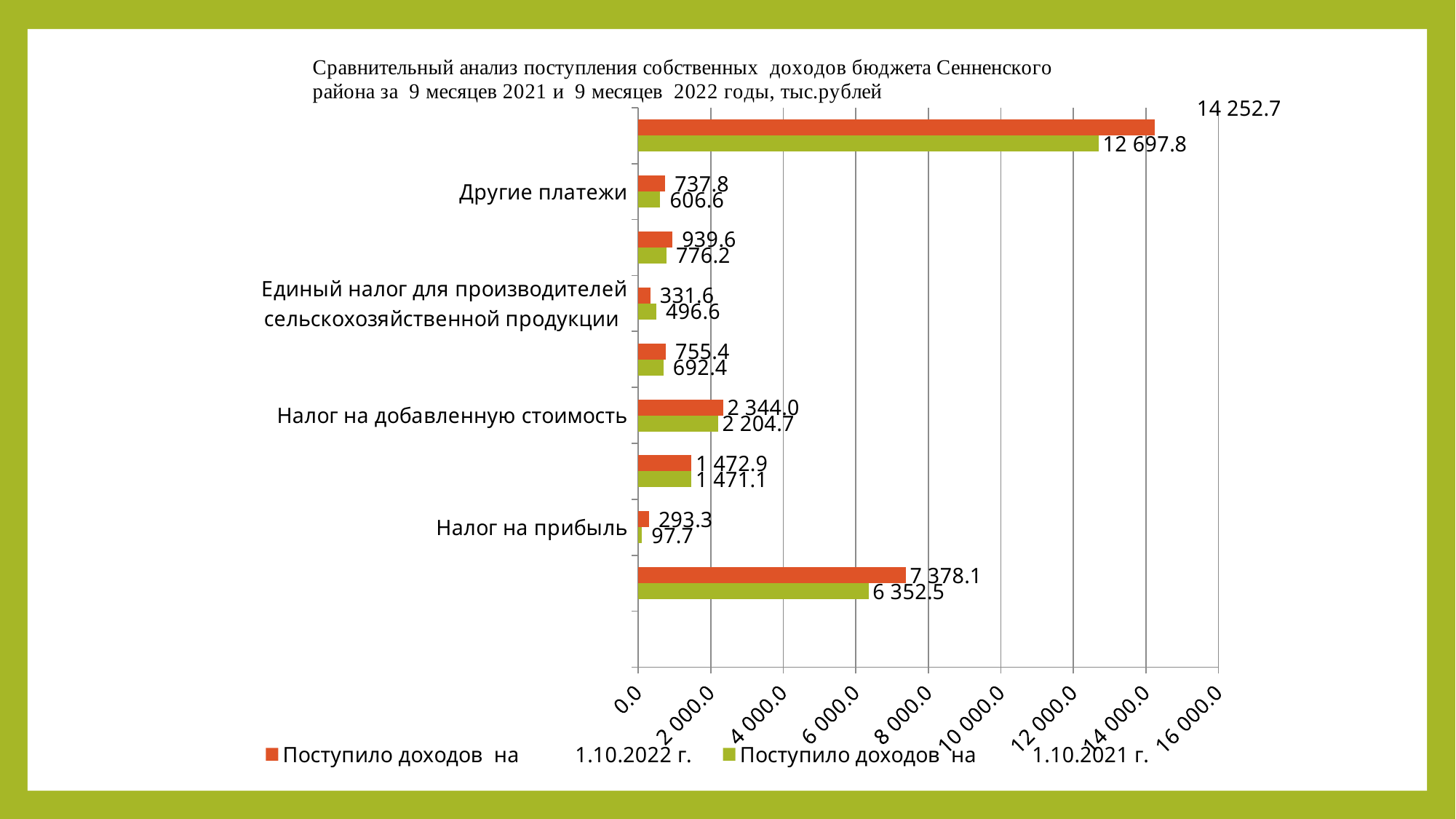
Which colour represents the series Поступило доходов на 1.10.2022 г.? orange What is the value for Налог на добавленную стоимость in the series Поступило доходов на 1.10.2022 г.? 2 344.0 How many series does the legend list? 2 What is the difference between the 2022 and 2021 values for Налог на добавленную стоимость? 139.3 What is the value for Другие платежи in the series Поступило доходов на 1.10.2021 г.? 606.6 For Налог на прибыль, which series has the larger value: Поступило доходов на 1.10.2022 г. or Поступило доходов на 1.10.2021 г.? Поступило доходов на 1.10.2022 г. What is the value for Единый налог для производителей сельскохозяйственной продукции in the series Поступило доходов на 1.10.2021 г.? 496.6 What is the value for Налог на прибыль in the series Поступило доходов на 1.10.2021 г.? 97.7 What is the value for Другие платежи in the series Поступило доходов на 1.10.2022 г.? 737.8 For Единый налог для производителей сельскохозяйственной продукции, which series has the larger value: Поступило доходов на 1.10.2022 г. or Поступило доходов на 1.10.2021 г.? Поступило доходов на 1.10.2021 г. What kind of chart is shown on the slide? bar chart What is the difference between the 2022 and 2021 values for Налог на прибыль? 195.6